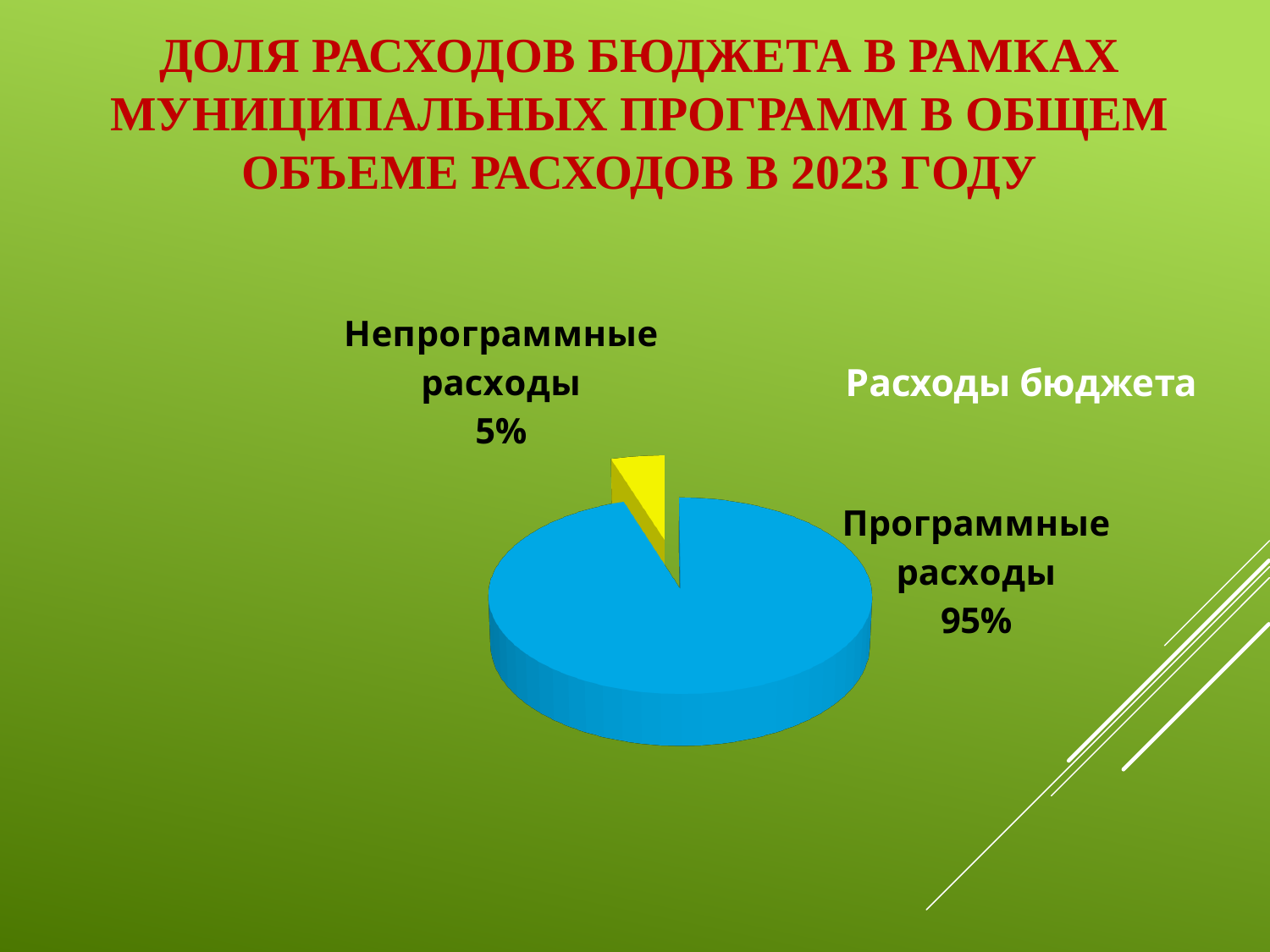
How many slices does the pie chart have? 2 What is the share of Непрограммные расходы in the pie chart? 5% Which category has the smallest slice of the pie? Непрограммные расходы What is the title of the pie chart? Расходы бюджета Which is larger: Программные расходы or Непрограммные расходы? Программные расходы What kind of chart is shown on the slide? pie chart What colour is the slice for Непрограммные расходы? yellow Which category has the largest slice of the pie? Программные расходы What is the difference in percentage points between Программные расходы and Непрограммные расходы? 90 What is the share of Программные расходы in the pie chart? 95%